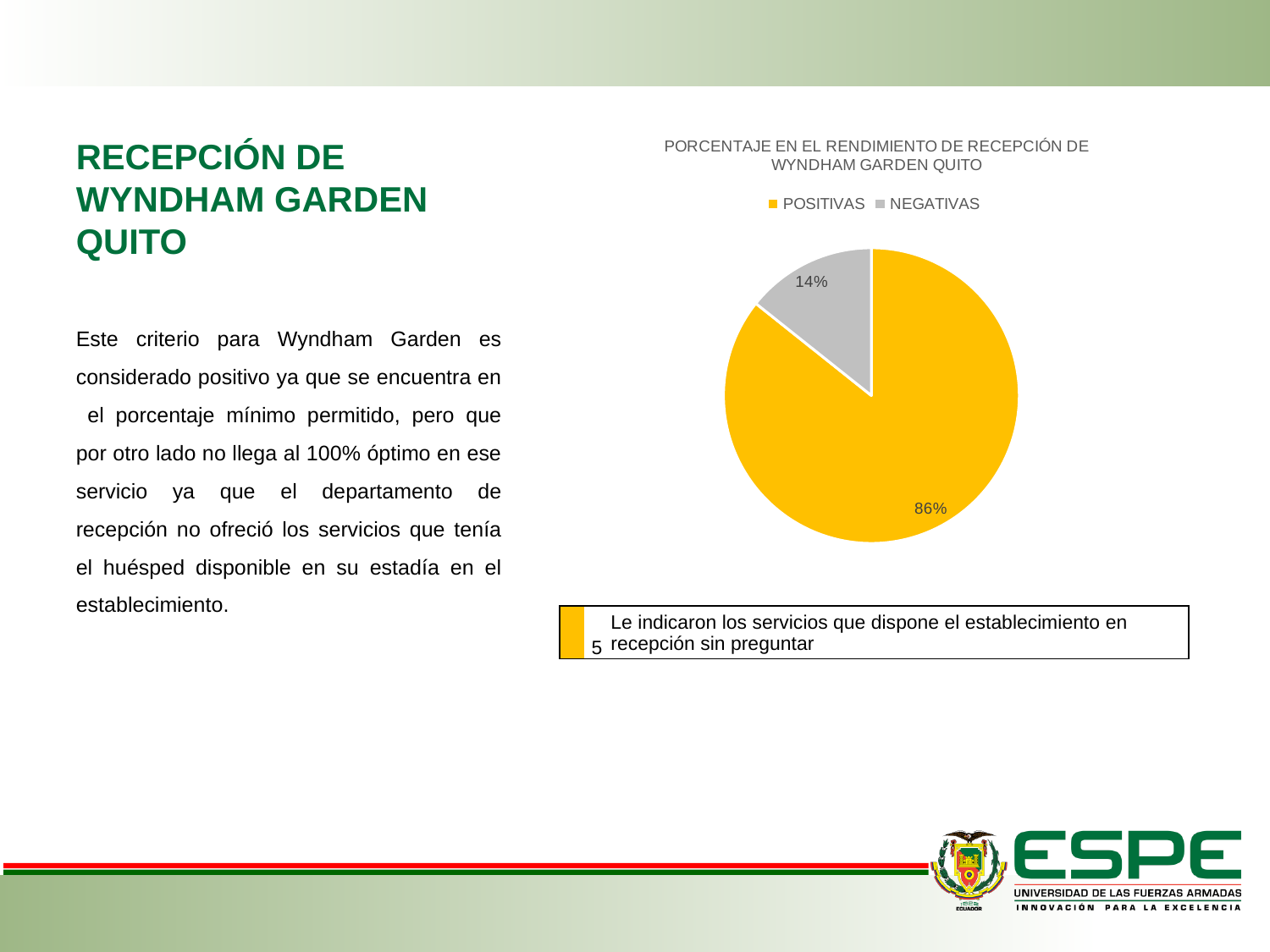
What type of chart is shown on the slide? Pie chart Which is larger, the POSITIVAS slice or the NEGATIVAS slice? POSITIVAS Which category has the largest share of the pie chart? POSITIVAS How many entries does the chart legend list? 2 Which category has the smallest share of the pie chart? NEGATIVAS How many categories are shown in the pie chart? 2 What percentage of the pie chart is NEGATIVAS? 14% What is the difference in percentage points between POSITIVAS and NEGATIVAS? 72 What is the title of the chart? PORCENTAJE EN EL RENDIMIENTO DE RECEPCIÓN DE WYNDHAM GARDEN QUITO What colour represents NEGATIVAS in the pie chart? Grey What percentage of the pie chart is POSITIVAS? 86%